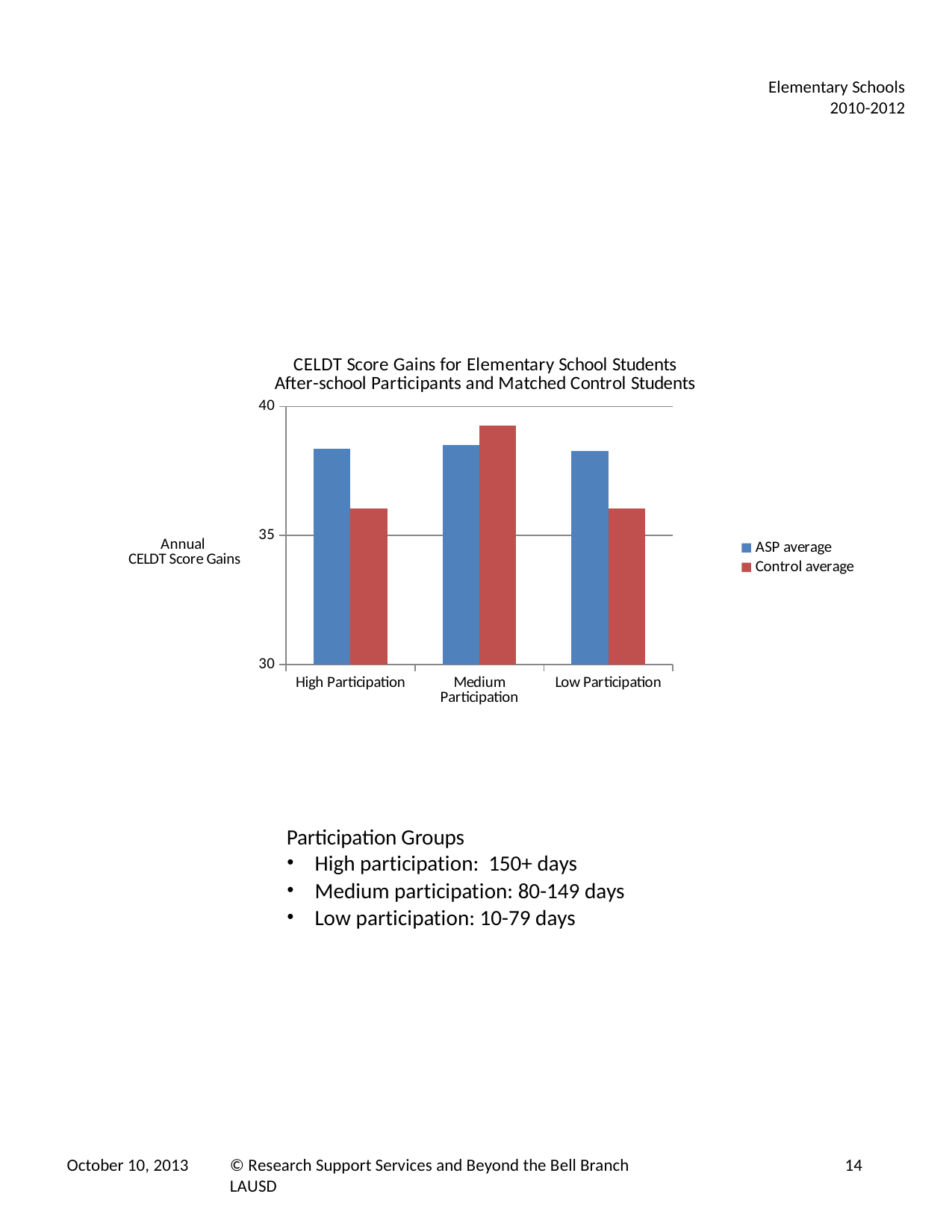
What is the label on the vertical axis? Annual CELDT Score Gains For Medium Participation, which is larger, the ASP average or the Control average? Control average For High Participation, which is larger, the ASP average or the Control average? ASP average Is the Control average for Medium Participation greater or less than 40? less What kind of chart is shown on the slide? bar chart Is the ASP average for Low Participation greater or less than 35? greater For Low Participation, which is larger, the ASP average or the Control average? ASP average Which series is shown in red? Control average Which participation group has the highest Control average? Medium Participation How many series does the legend list? 2 Is the Control average for High Participation greater or less than 35? greater How many participation groups are shown on the x axis? 3